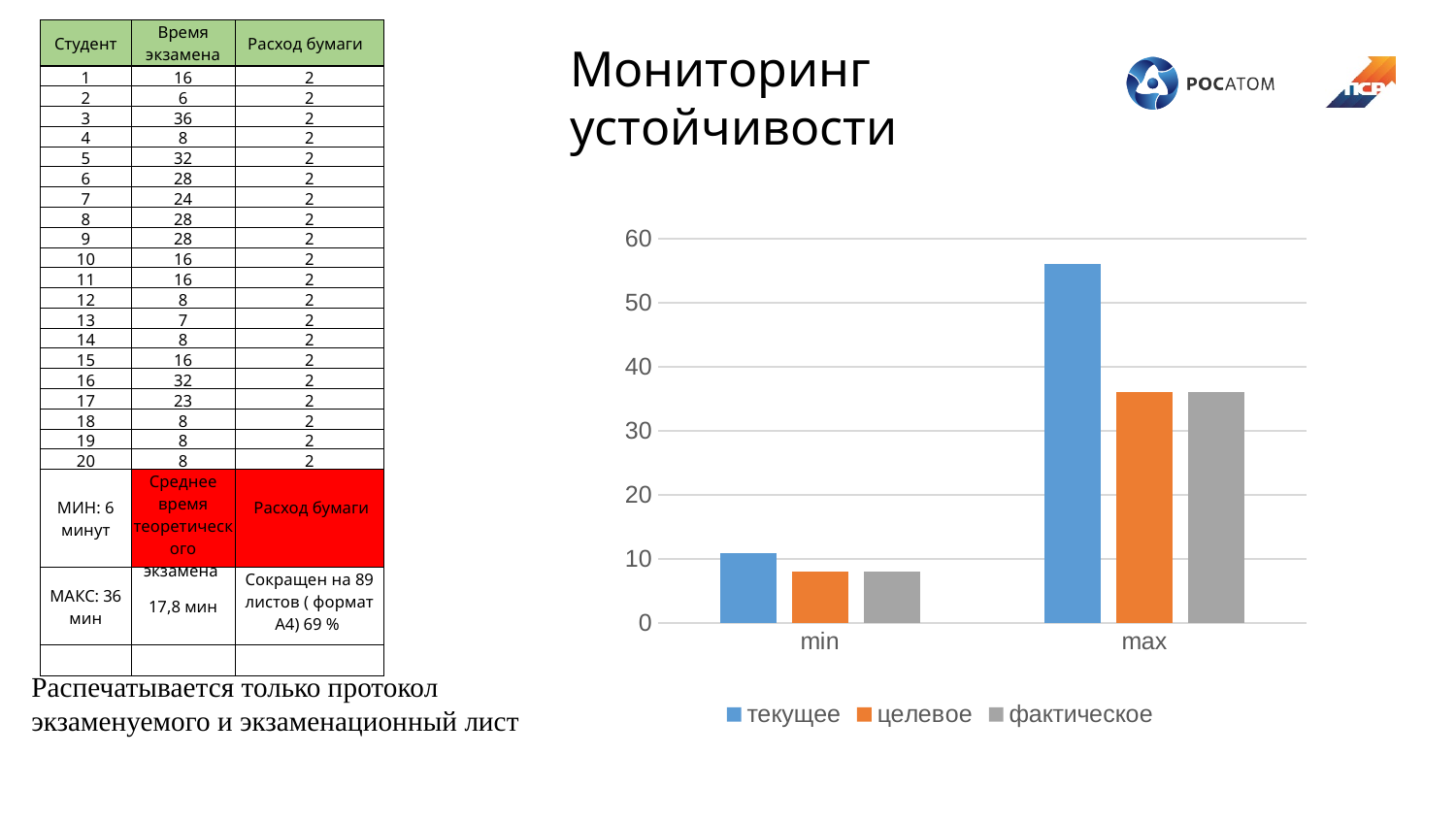
What kind of chart is shown on the slide? bar chart Is the value of целевое for min greater or less than 10? less Is the value of целевое for max greater or less than 40? less What are the two categories on the x axis of the chart? min and max Is the value of текущее for max greater or less than 50? greater How many series does the chart legend list? 3 For the max category, which is larger: текущее or целевое? текущее Which series has the highest value in the max category? текущее How many categories are shown on the x axis of the chart? 2 For the min category, which is larger: текущее or фактическое? текущее Which series is shown in blue in the chart? текущее